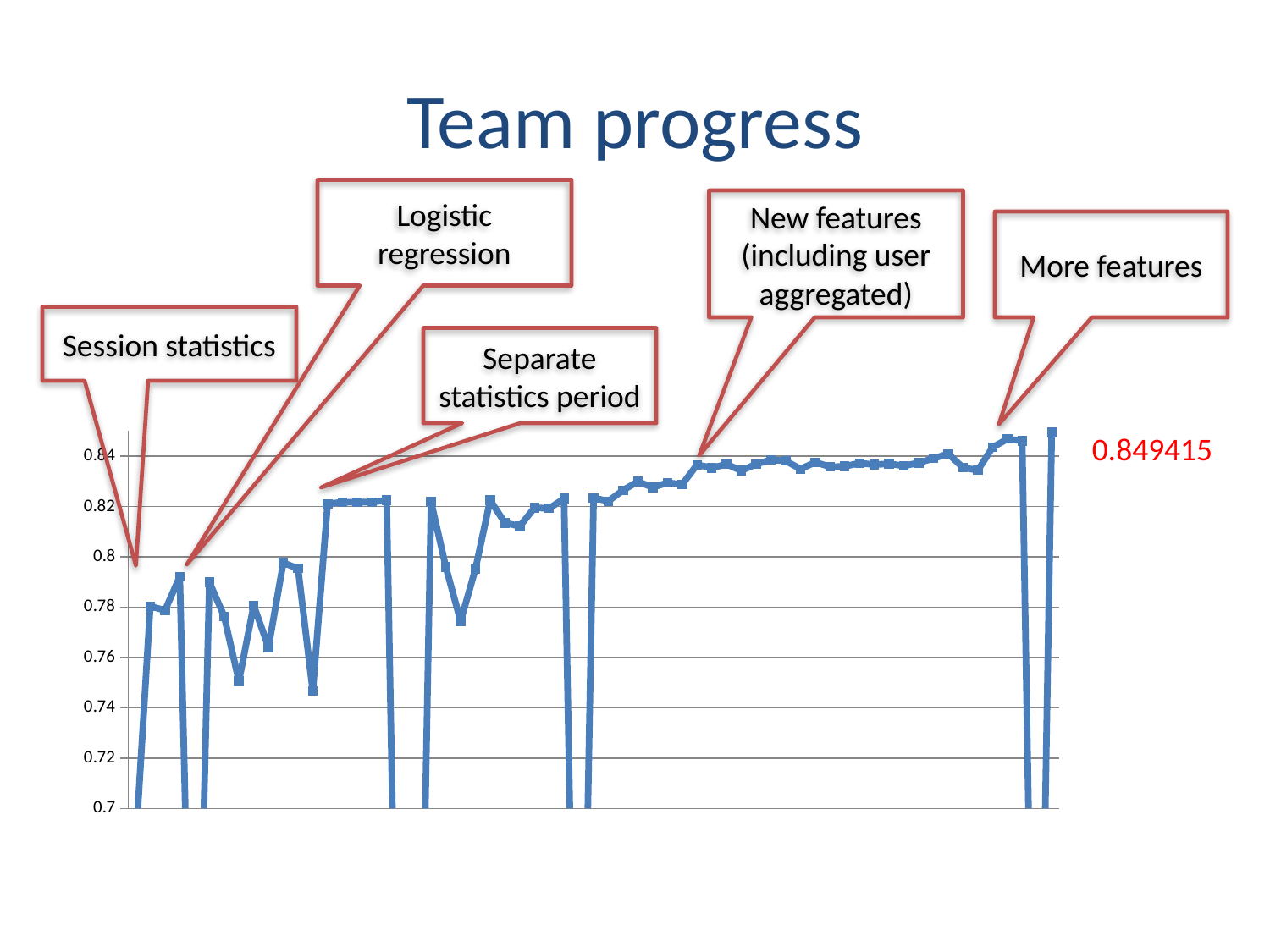
What is the lowest tick value shown on the y axis? 0.7 What kind of chart is shown on the slide? line chart Overall, do the values of the line rise or fall from left to right? rise What value is printed in red next to the end of the line? 0.849415 Is the value at the point labelled 'More features' greater or less than 0.82? greater What is the highest tick value shown on the y axis? 0.84 Is the final value of the line (0.849415) greater or less than 0.84? greater How many annotation callouts point to the line on the chart? 5 How many data series are plotted on the chart? 1 What is the title of the chart on the slide? Team progress Which callout label is attached to the rightmost part of the line? More features